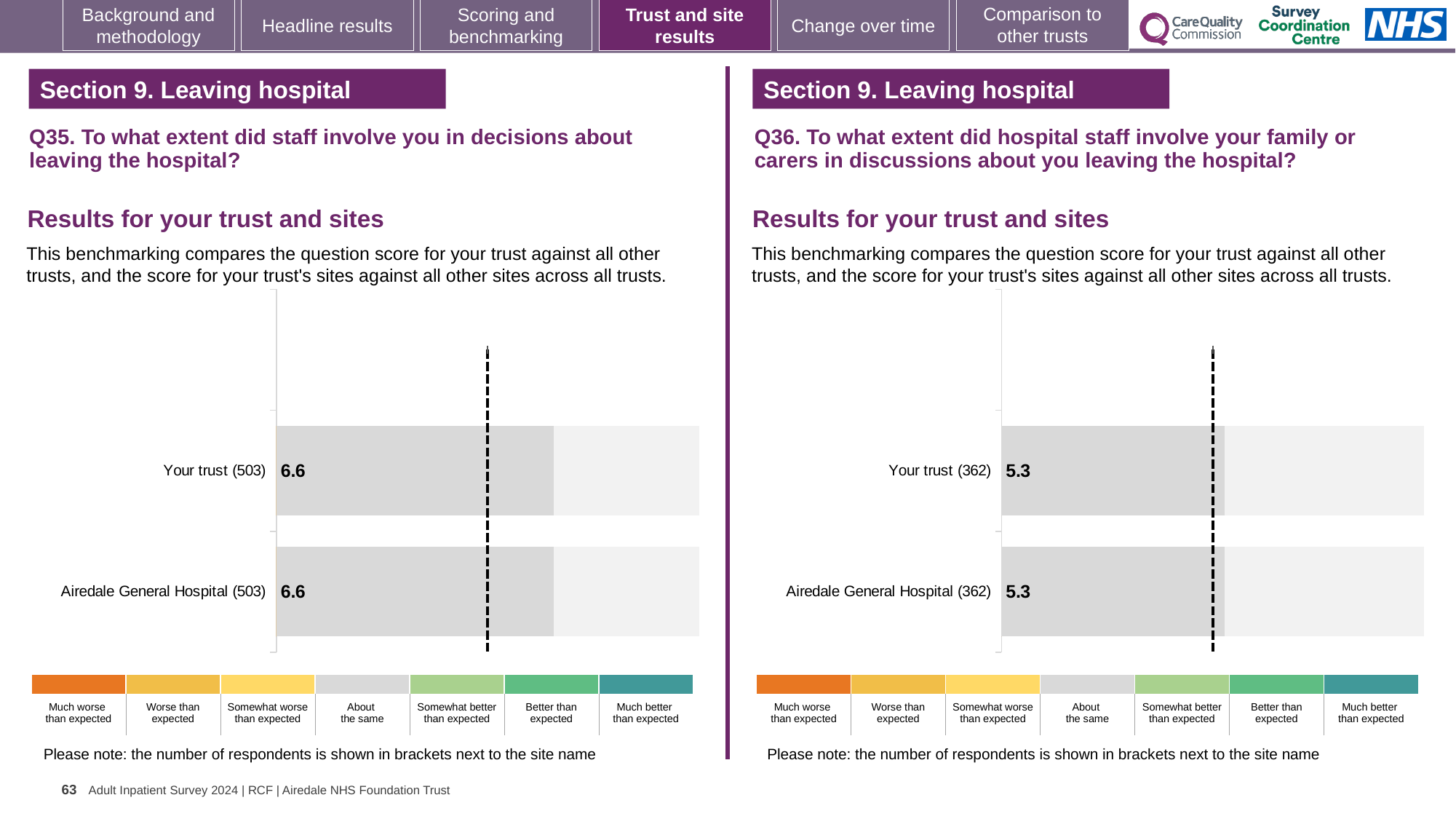
In the Q35 chart on the left, what is the score for Airedale General Hospital? 6.6 In the Q36 chart on the right, what is the score for Airedale General Hospital? 5.3 In the Q36 chart on the right, what is the difference between the score for Your trust and the score for Airedale General Hospital? 0 In the Q35 chart on the left, what is the score for Your trust? 6.6 How many categories does the colour key below each chart list, from 'Much worse than expected' to 'Much better than expected'? 7 In the Q35 chart on the left, what is the difference between the score for Your trust and the score for Airedale General Hospital? 0 In the Q36 chart on the right, what is the score for Your trust? 5.3 How many bars are plotted in the Q36 chart on the right? 2 How many bars are plotted in the Q35 chart on the left? 2 What kind of chart is used in the Q35 chart on the left? Bar chart In the Q35 chart on the left, how many respondents are shown in brackets for Your trust? 503 In the Q36 chart on the right, how many respondents are shown in brackets for Airedale General Hospital? 362